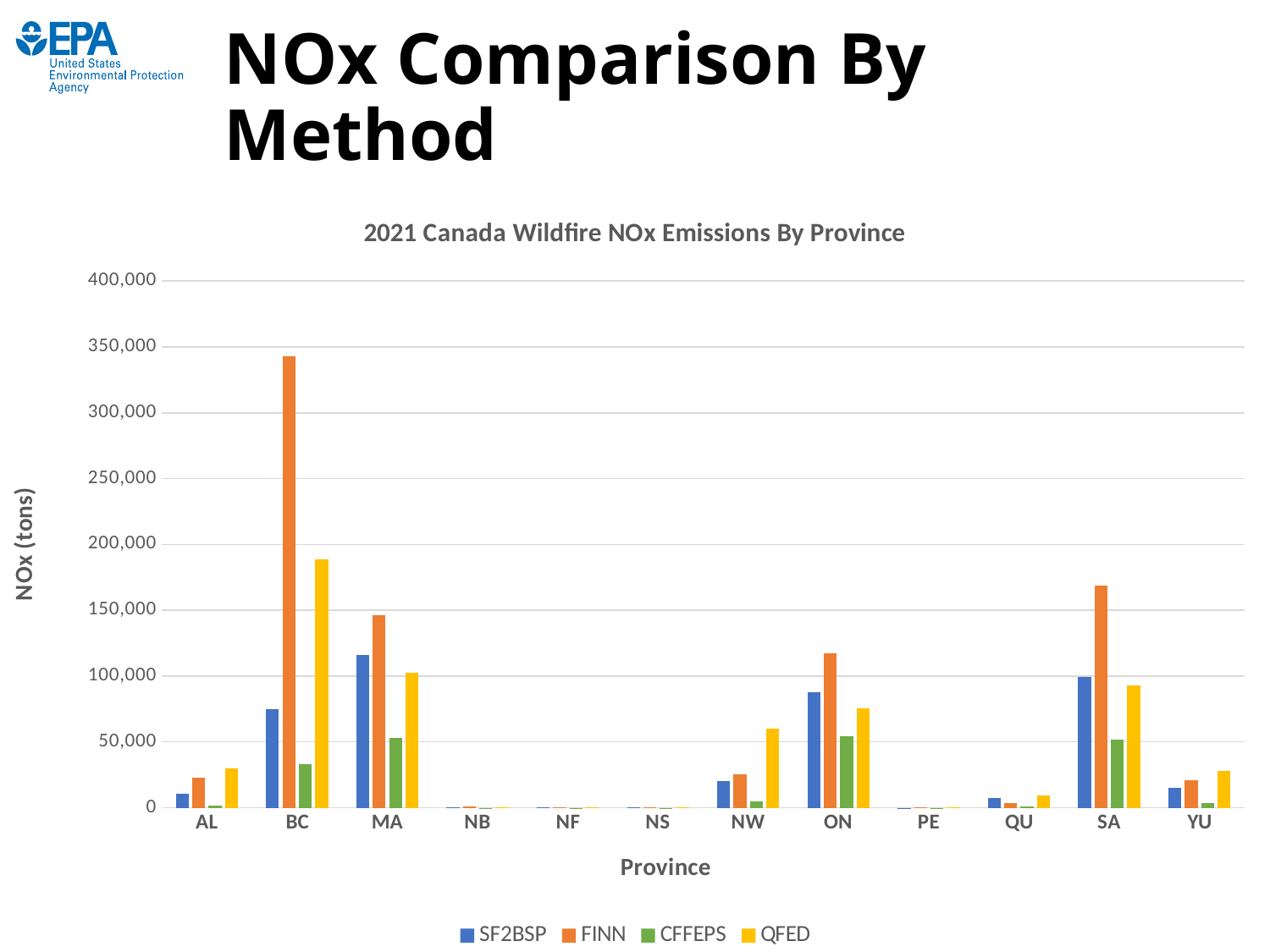
Is the QFED value for NW greater or less than 50,000? greater Is the QFED value for BC greater or less than 200,000? less Which province has the highest QFED value? BC Is the FINN value for BC greater or less than 300,000? greater What kind of chart is shown on the slide? bar chart How many provinces are shown on the x axis? 12 How many series does the legend list? 4 What is the title of the chart? 2021 Canada Wildfire NOx Emissions By Province Which province has the larger FINN value, MA or SA? SA Which province has the highest FINN value? BC Which is larger for ON, the SF2BSP value or the FINN value? FINN